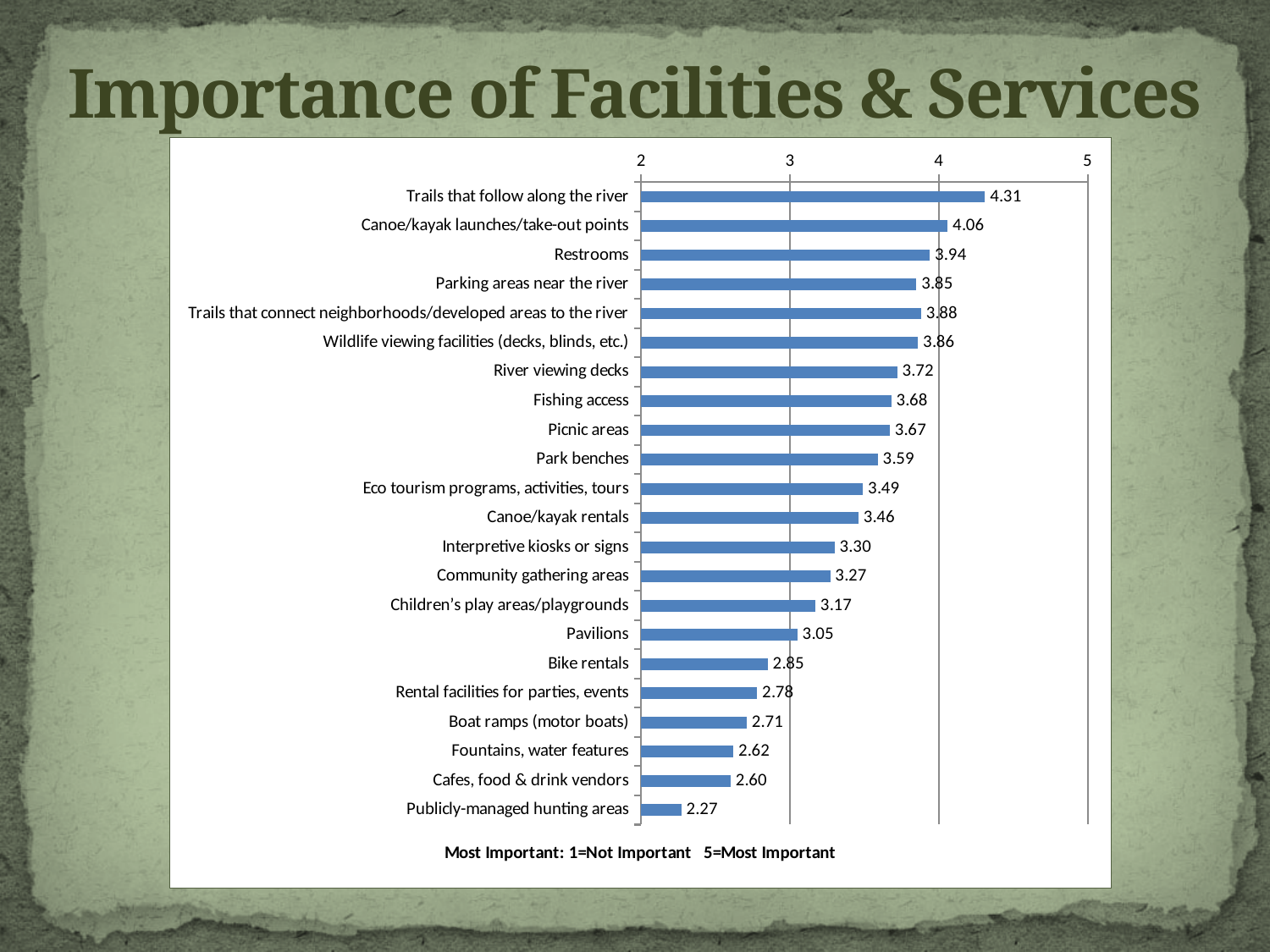
What is the value for Bike rentals? 2.85 What is the value for Restrooms? 3.94 What is the title of the slide's chart? Importance of Facilities & Services What kind of chart is shown on the slide? Bar chart Which category has the lowest value? Publicly-managed hunting areas How many categories are shown in the chart? 22 Is the value for Interpretive kiosks or signs greater or less than 3? greater What is the difference between the values for Pavilions and Publicly-managed hunting areas? 0.78 Which has a larger value, Picnic areas or Park benches? Picnic areas Which category has the highest value? Trails that follow along the river What is the difference between the values for Trails that follow along the river and Canoe/kayak launches/take-out points? 0.25 What is the value for Fishing access? 3.68